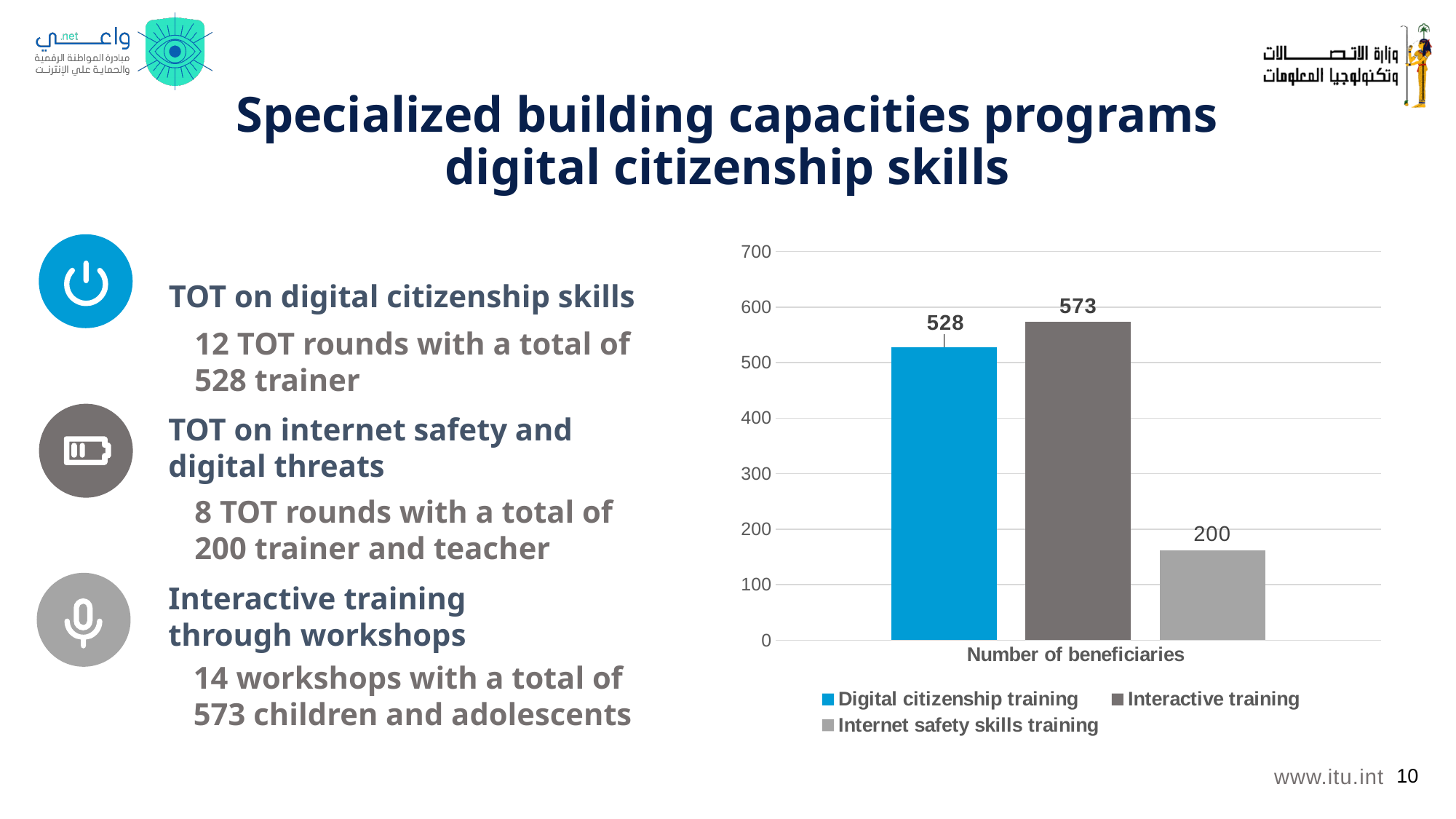
What is the number of beneficiaries for Interactive training? 573 Is the value for Interactive training greater or less than 500? greater Which series has the highest number of beneficiaries? Interactive training What is the label on the x axis of the chart? Number of beneficiaries What is the number of beneficiaries for Internet safety skills training? 200 Which series has the lowest number of beneficiaries? Internet safety skills training Which has more beneficiaries, Digital citizenship training or Internet safety skills training? Digital citizenship training How many series does the legend list? 3 What is the difference in beneficiaries between Interactive training and Digital citizenship training? 45 What is the difference in beneficiaries between Digital citizenship training and Internet safety skills training? 328 What is the number of beneficiaries for Digital citizenship training? 528 What kind of chart is shown on the slide? Bar chart